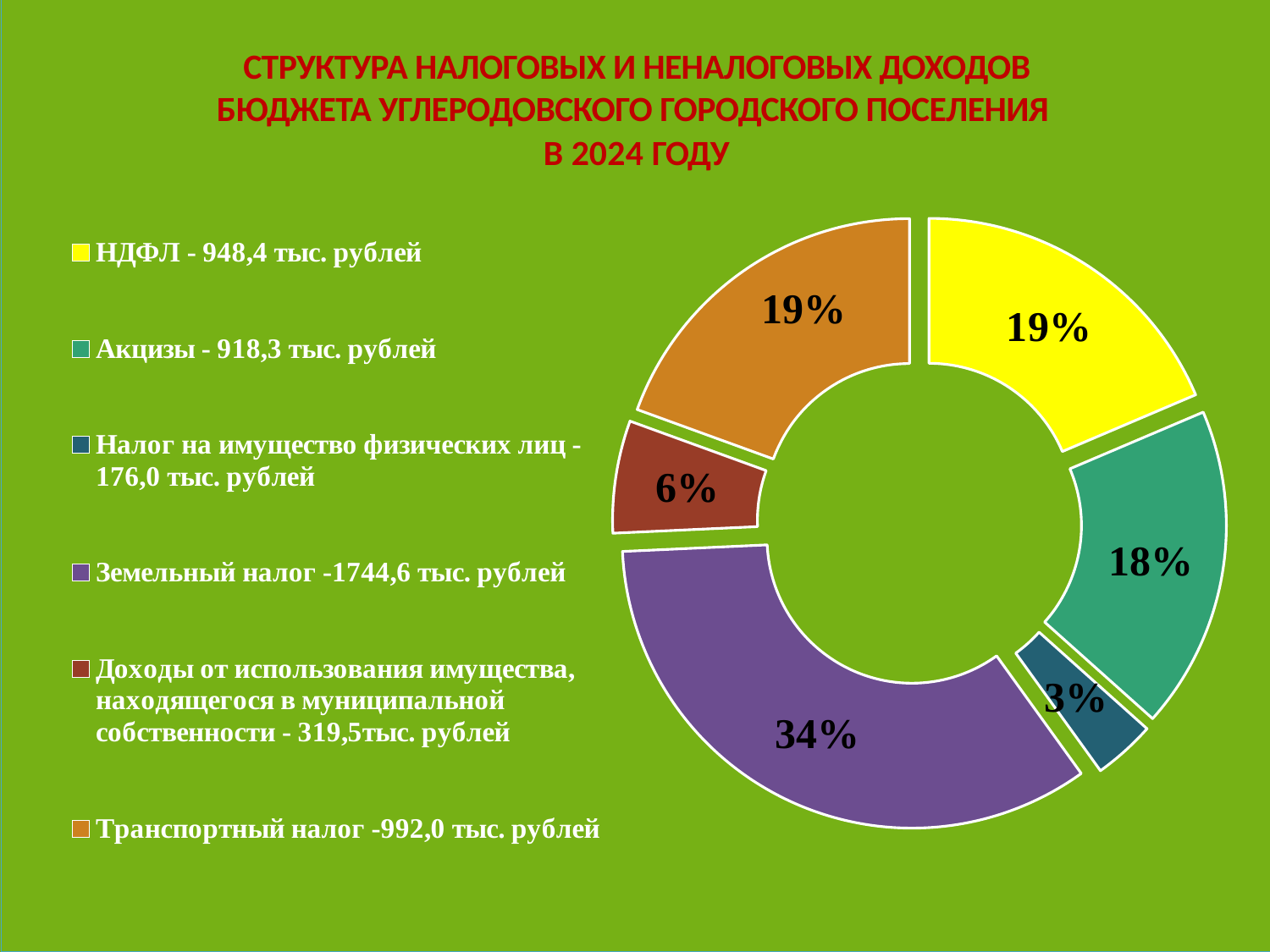
Which category has the largest share of the chart? Земельный налог How many categories does the chart show? 6 According to the legend, what is the amount for Транспортный налог? 992,0 тыс. рублей Which category has the smallest share of the chart? Налог на имущество физических лиц What percentage is shown for the Налог на имущество физических лиц slice? 3% What is the difference in percentage points between the Земельный налог slice and the Транспортный налог slice? 15 percentage points What colour is the slice for Земельный налог? Purple Which is larger, the share for Акцизы or the share for Доходы от использования имущества, находящегося в муниципальной собственности? Акцизы What percentage is shown for the Акцизы slice? 18% What kind of chart is shown on the slide? Doughnut (pie) chart According to the legend, what is the amount for НДФЛ? 948,4 тыс. рублей What share of the doughnut chart does Земельный налог account for? 34%